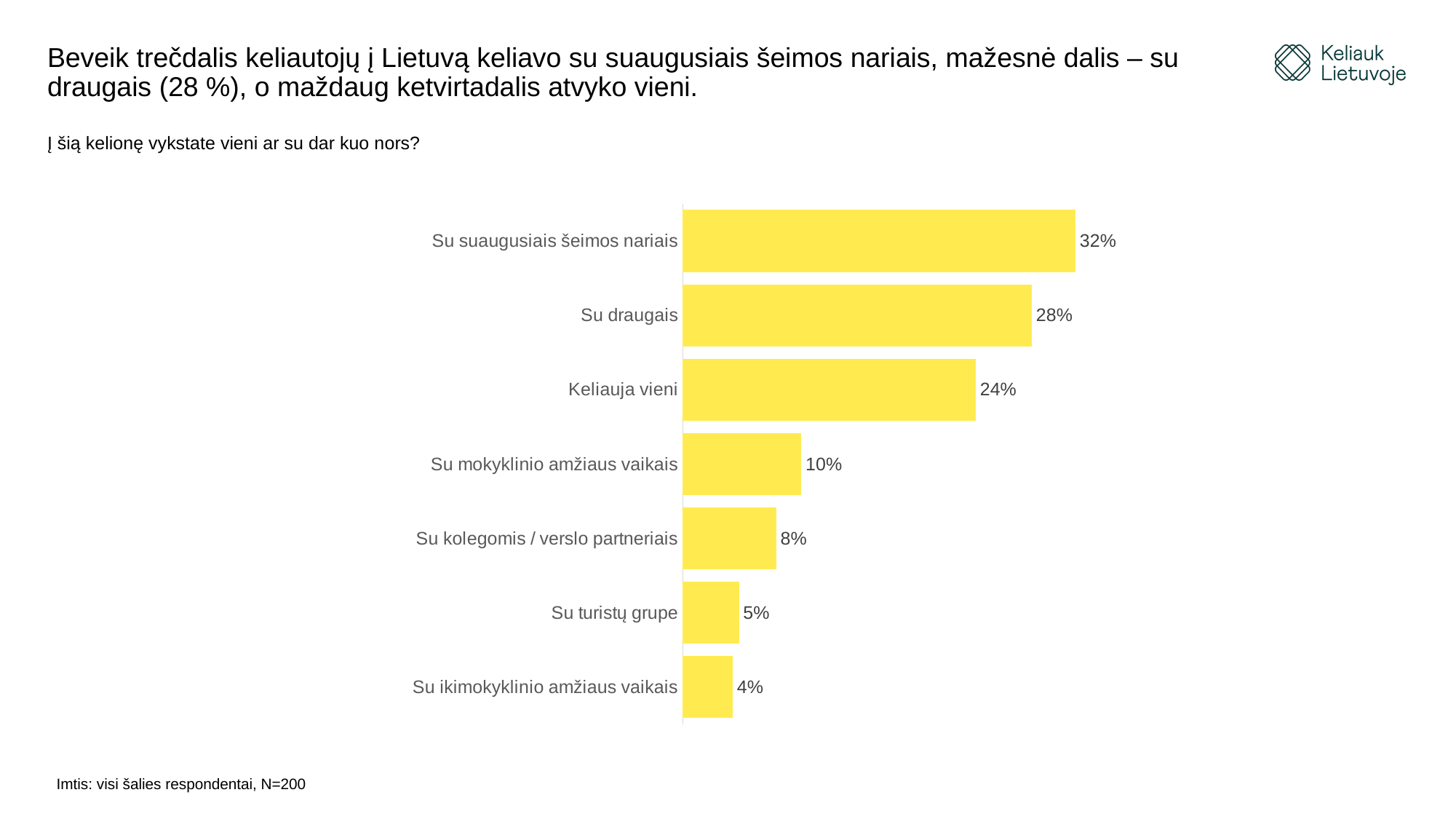
What is the value for "Su mokyklinio amžiaus vaikais"? 10% What kind of chart is shown on the slide? Bar chart What is the value for "Su turistų grupe"? 5% What is the value for "Su draugais"? 28% What is the difference between "Su suaugusiais šeimos nariais" and "Keliauja vieni"? 8% Which is larger: "Su turistų grupe" or "Su kolegomis / verslo partneriais"? Su kolegomis / verslo partneriais What is the sample size stated at the bottom of the slide? N=200 Which is larger: "Su draugais" or "Keliauja vieni"? Su draugais Which category has the lowest value? Su ikimokyklinio amžiaus vaikais Which category has the highest value? Su suaugusiais šeimos nariais What is the difference between "Su kolegomis / verslo partneriais" and "Su ikimokyklinio amžiaus vaikais"? 4% How many categories are shown in the chart? 7